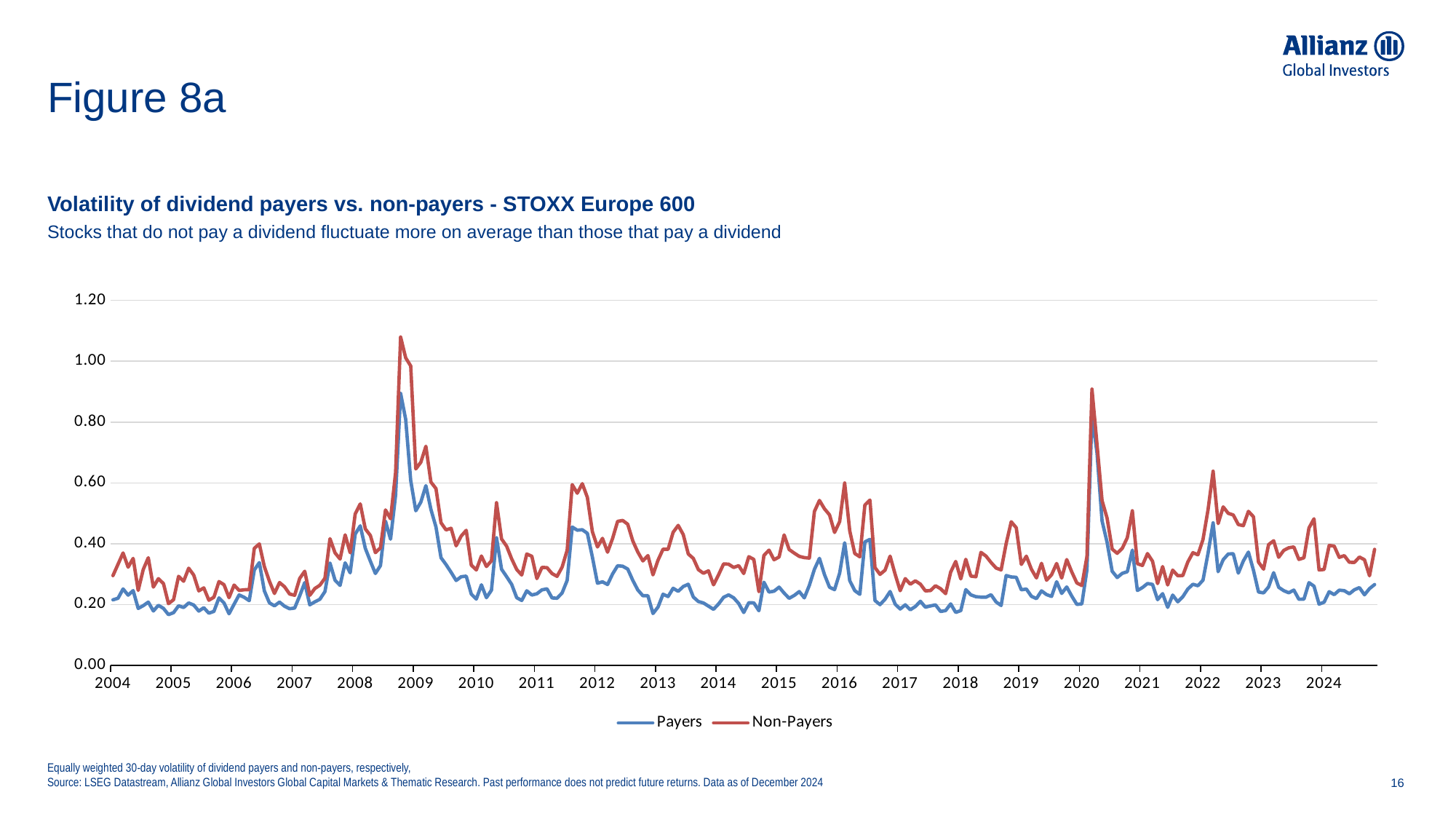
Is the value of the Payers line at the end of 2024 greater or less than 0.40? less How many series does the legend list? 2 How many year labels are shown on the x axis? 21 What is the title of the chart? Volatility of dividend payers vs. non-payers - STOXX Europe 600 Is the Non-Payers spike in 2020 greater or less than 0.80? greater Is the highest value reached by the Non-Payers line greater or less than 1.00? greater Which series generally runs above the other across the chart, Payers or Non-Payers? Non-Payers Which series is higher at the 2020 spike, Payers or Non-Payers? Non-Payers What kind of chart is shown on the slide? Line chart What are the two series named in the legend? Payers and Non-Payers